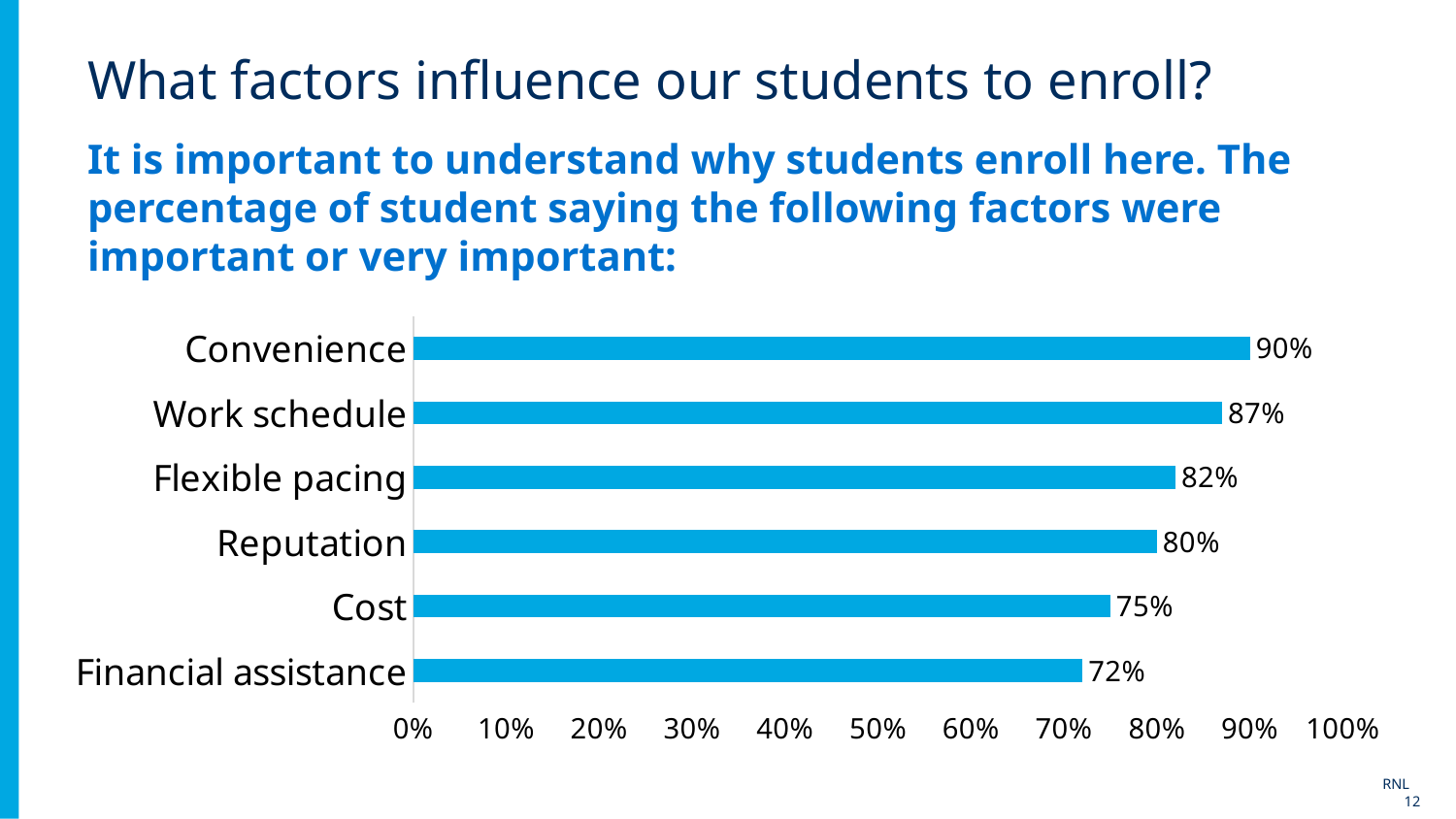
What is the maximum value shown on the horizontal axis? 100% What is the value shown for Financial assistance? 72% Which has a higher value, Cost or Reputation? Reputation What is the value shown for Reputation? 80% What is the difference between the values for Work schedule and Flexible pacing? 5% What is the difference between the values for Convenience and Financial assistance? 18% What kind of chart is shown on the slide? Bar chart Which factor has the lowest percentage? Financial assistance How many factors are shown in the chart? 6 Is the value for Cost greater or less than 70%? greater What percentage of students said Convenience was important or very important? 90% Which factor has the highest percentage? Convenience